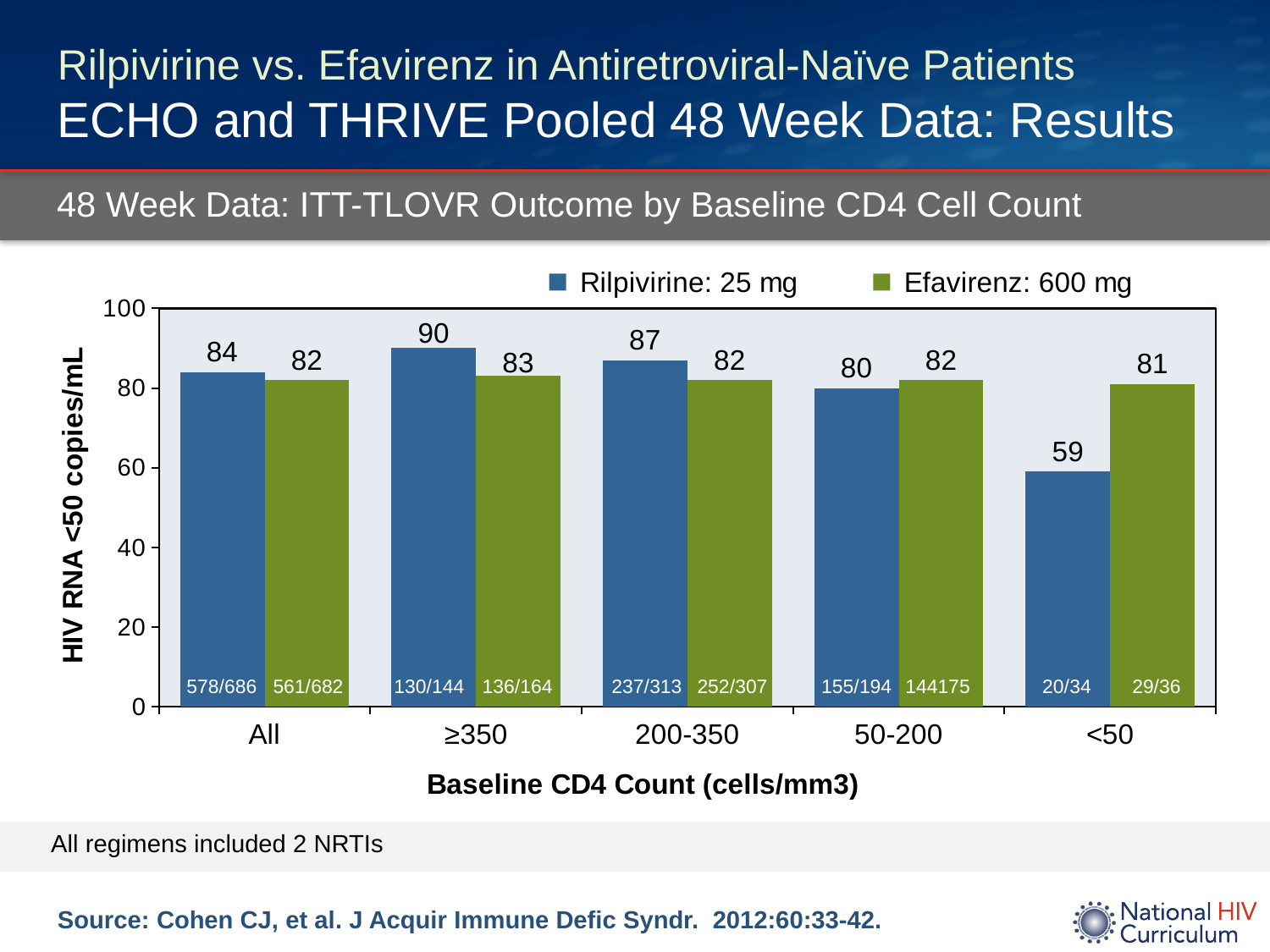
Which baseline CD4 count category has the lowest value for Rilpivirine: 25 mg? <50 What is the value for Efavirenz: 600 mg in the <50 baseline CD4 count category? 81 How many series does the legend list? 2 What is the value for Rilpivirine: 25 mg in the ≥350 baseline CD4 count category? 90 Which baseline CD4 count category has the highest value for Rilpivirine: 25 mg? ≥350 What is the difference between the Rilpivirine: 25 mg values for the ≥350 and 50-200 categories? 10 What is the difference between the Efavirenz: 600 mg and Rilpivirine: 25 mg values in the <50 category? 22 How many baseline CD4 count categories are shown on the x axis? 5 What kind of chart is shown on the slide? Bar chart What is the label of the y axis? HIV RNA <50 copies/mL In the 200-350 category, which series has the larger value, Rilpivirine: 25 mg or Efavirenz: 600 mg? Rilpivirine: 25 mg What is the value for Rilpivirine: 25 mg in the All category? 84